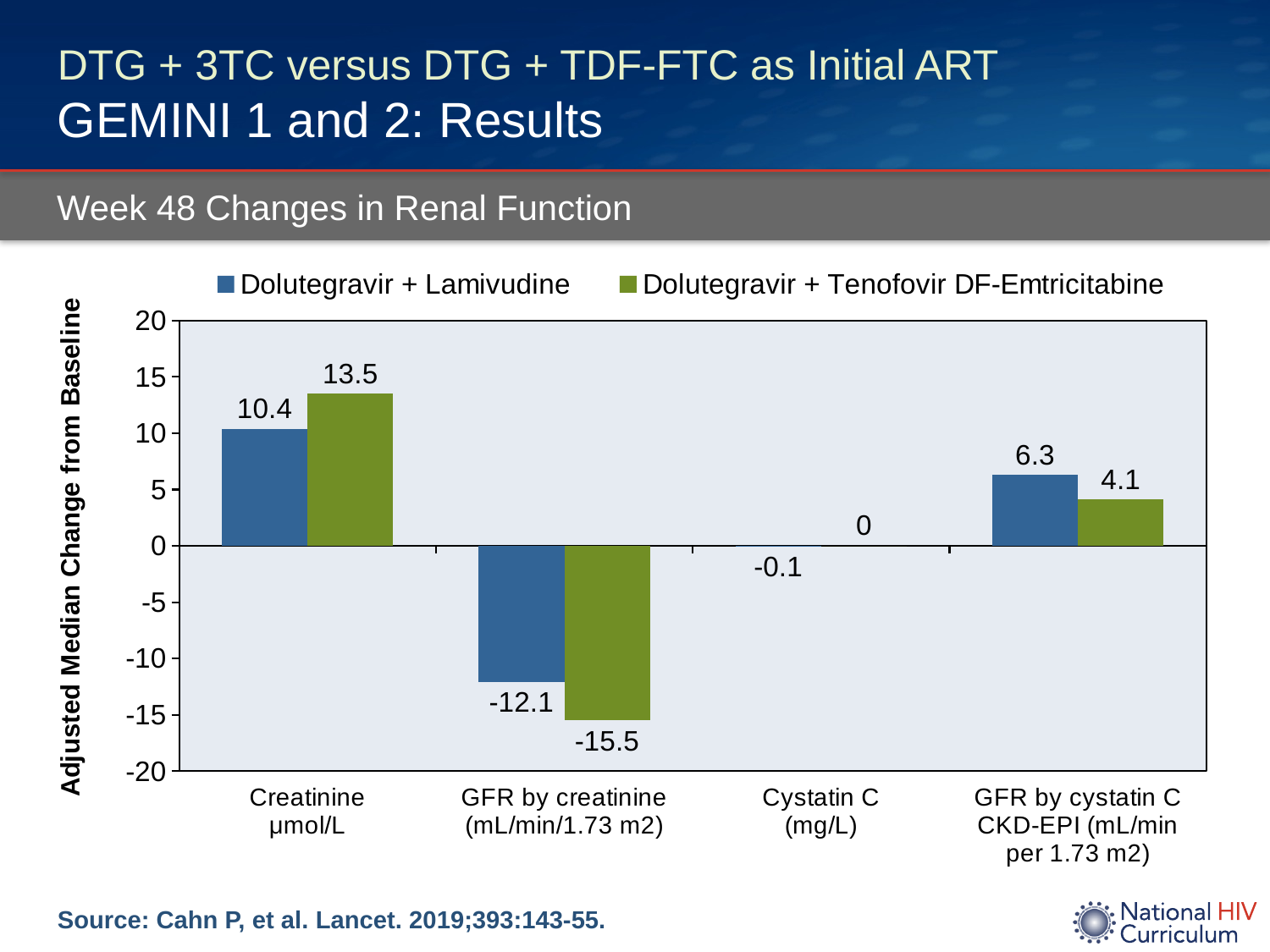
What is the value for GFR by cystatin C CKD-EPI for Dolutegravir + Tenofovir DF-Emtricitabine? 4.1 Which category has the highest value for Dolutegravir + Lamivudine? Creatinine µmol/L What kind of chart is shown on the slide? Bar chart Which category has the lowest value for Dolutegravir + Tenofovir DF-Emtricitabine? GFR by creatinine (mL/min/1.73 m2) What is the difference between the two series' values for GFR by creatinine? 3.4 What is the adjusted median change from baseline in creatinine for Dolutegravir + Lamivudine? 10.4 What is the value for GFR by creatinine for Dolutegravir + Tenofovir DF-Emtricitabine? -15.5 What is the value for Cystatin C for Dolutegravir + Lamivudine? -0.1 How many series does the legend list? 2 How many categories are shown on the x axis? 4 For GFR by cystatin C CKD-EPI, which series has the larger value? Dolutegravir + Lamivudine What is the adjusted median change from baseline in creatinine for Dolutegravir + Tenofovir DF-Emtricitabine? 13.5